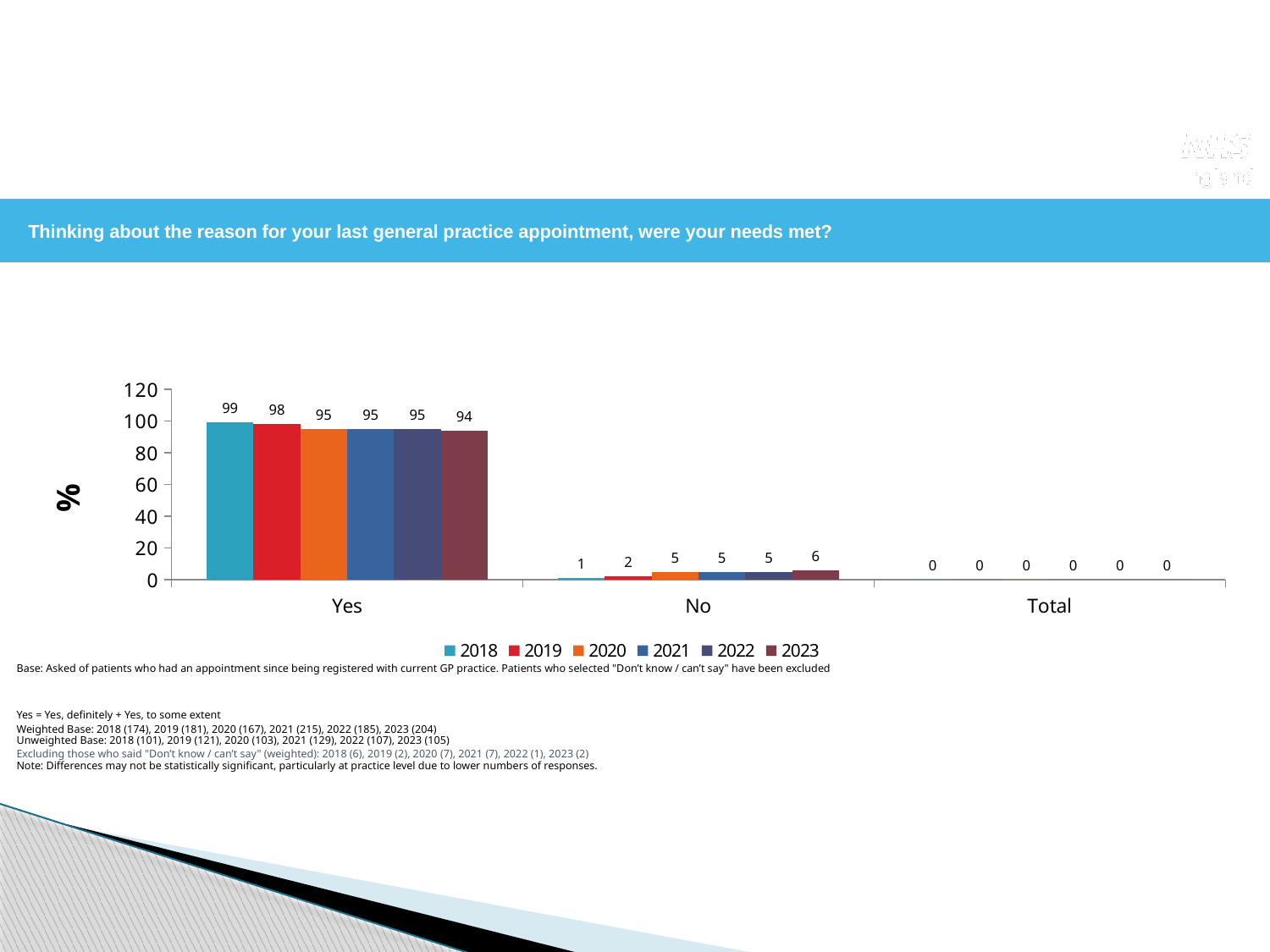
Is the value for 2021 in the Yes category greater or less than 80? greater What is the label on the y axis? % What kind of chart is shown on the slide? bar chart What is the value for 2019 in the No category? 2 What is the difference between the 2018 and 2023 values in the Yes category? 5 Which year has the lowest value in the Yes category? 2023 What is the value for 2018 in the Yes category? 99 What is the value for 2023 in the No category? 6 Which year has the highest value in the Yes category? 2018 Which is larger: the 2020 value for No or the 2019 value for No? 2020 How many categories are shown on the x axis? 3 How many series does the legend list? 6